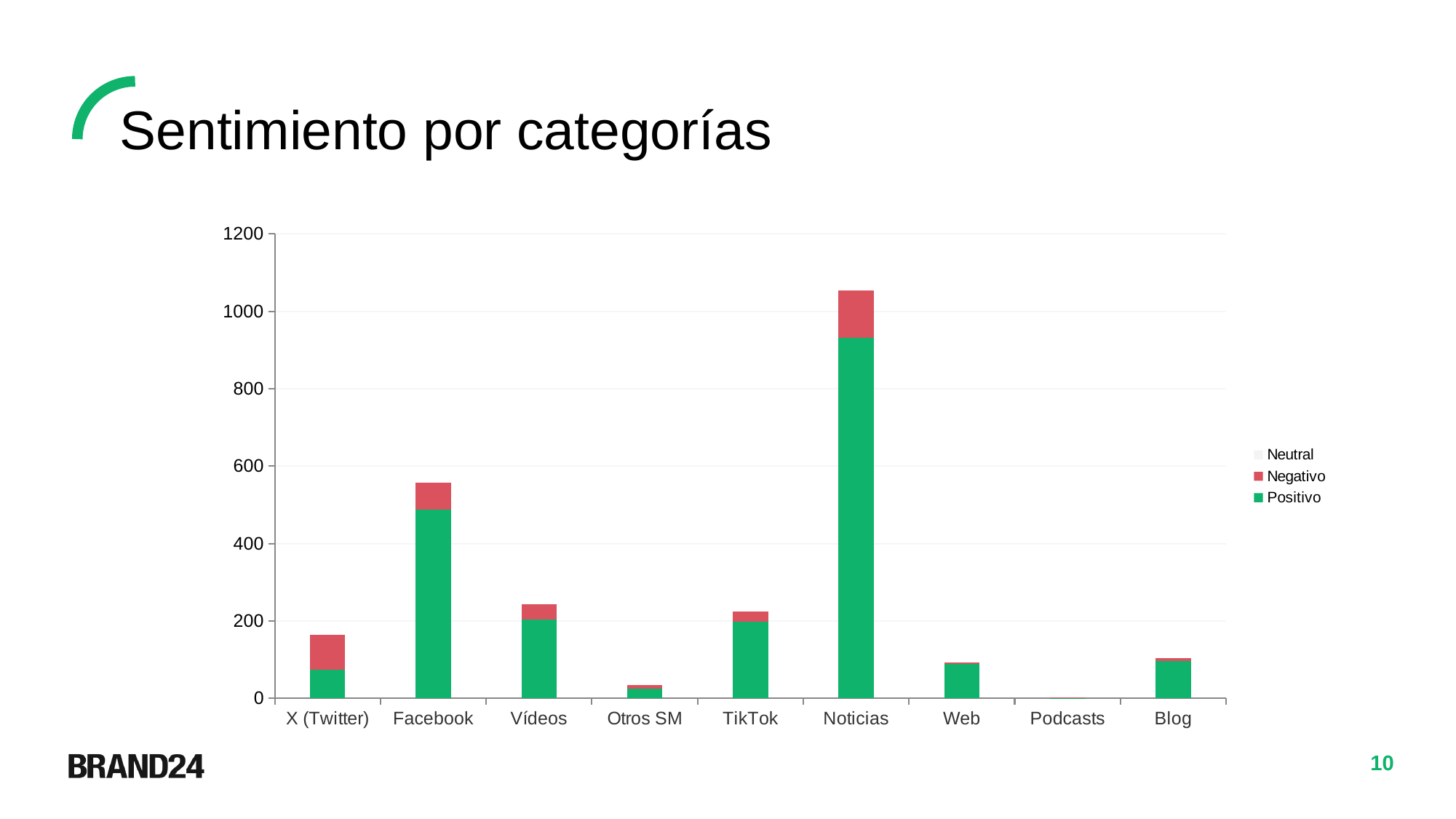
Is the total bar height for X (Twitter) greater or less than 200? less Is the total bar height for Facebook greater or less than 400? greater Which has the taller bar, Facebook or Vídeos? Facebook Is the Positivo value for Noticias greater or less than 800? greater What kind of chart is shown on the slide? bar chart Which colour represents the Positivo series in the legend? green Which category has the tallest bar? Noticias How many series does the legend list? 3 How many categories are shown on the x axis? 9 Which category has the shortest bar? Podcasts What is the title of the chart? Sentimiento por categorías